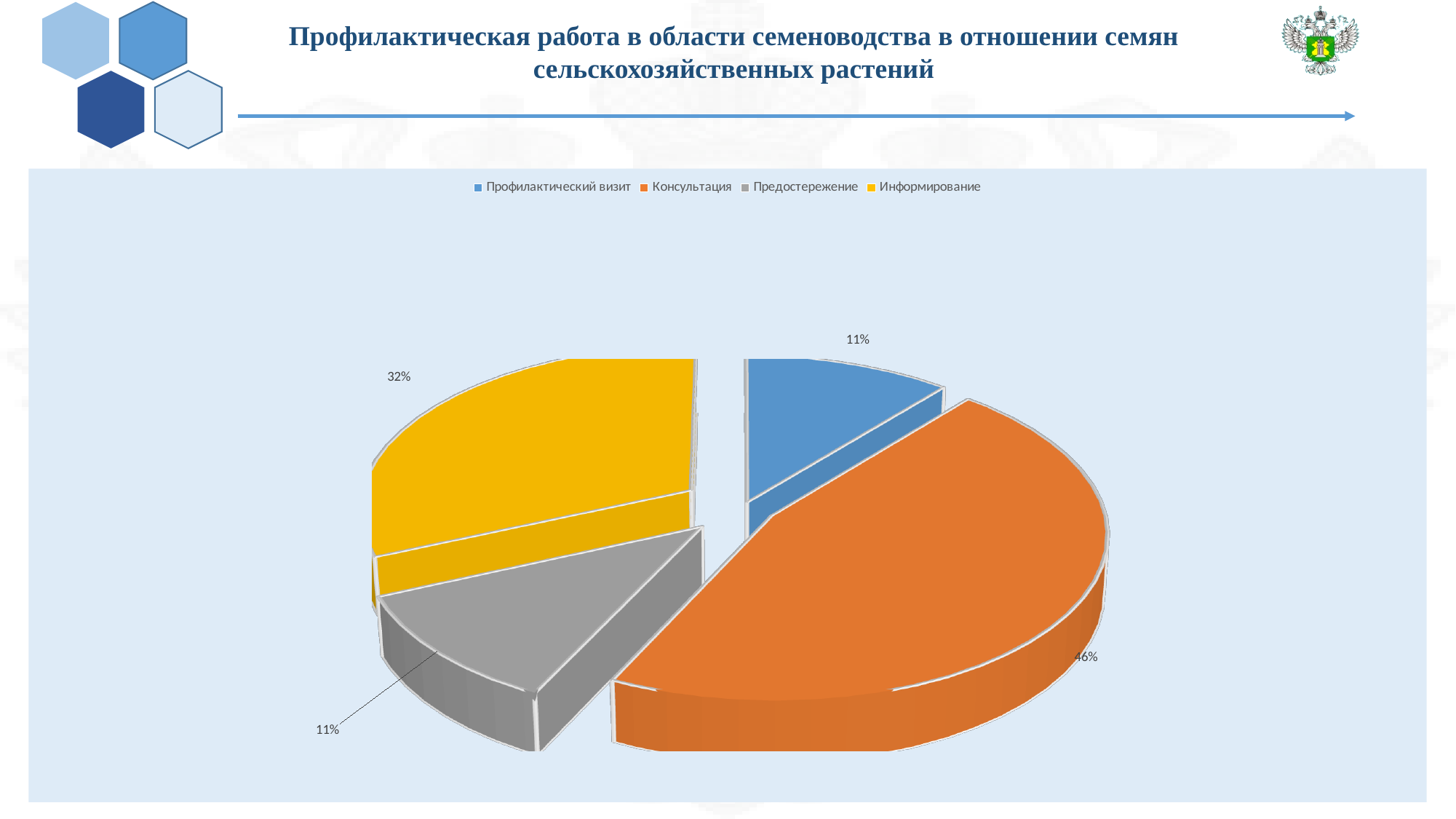
What share of the pie does Предостережение take? 11% What share of the pie does Информирование take? 32% Which is larger, the share for Консультация or the share for Информирование? Консультация Which category has the largest slice of the pie? Консультация What colour is the slice for Информирование? yellow What share of the pie does Профилактический визит take? 11% Which is larger, the share for Информирование or the share for Профилактический визит? Информирование How many entries does the legend list? 4 What is the difference in percentage points between the shares for Консультация and Информирование? 14 What kind of chart is shown on the slide? pie chart How many slices does the pie chart have? 4